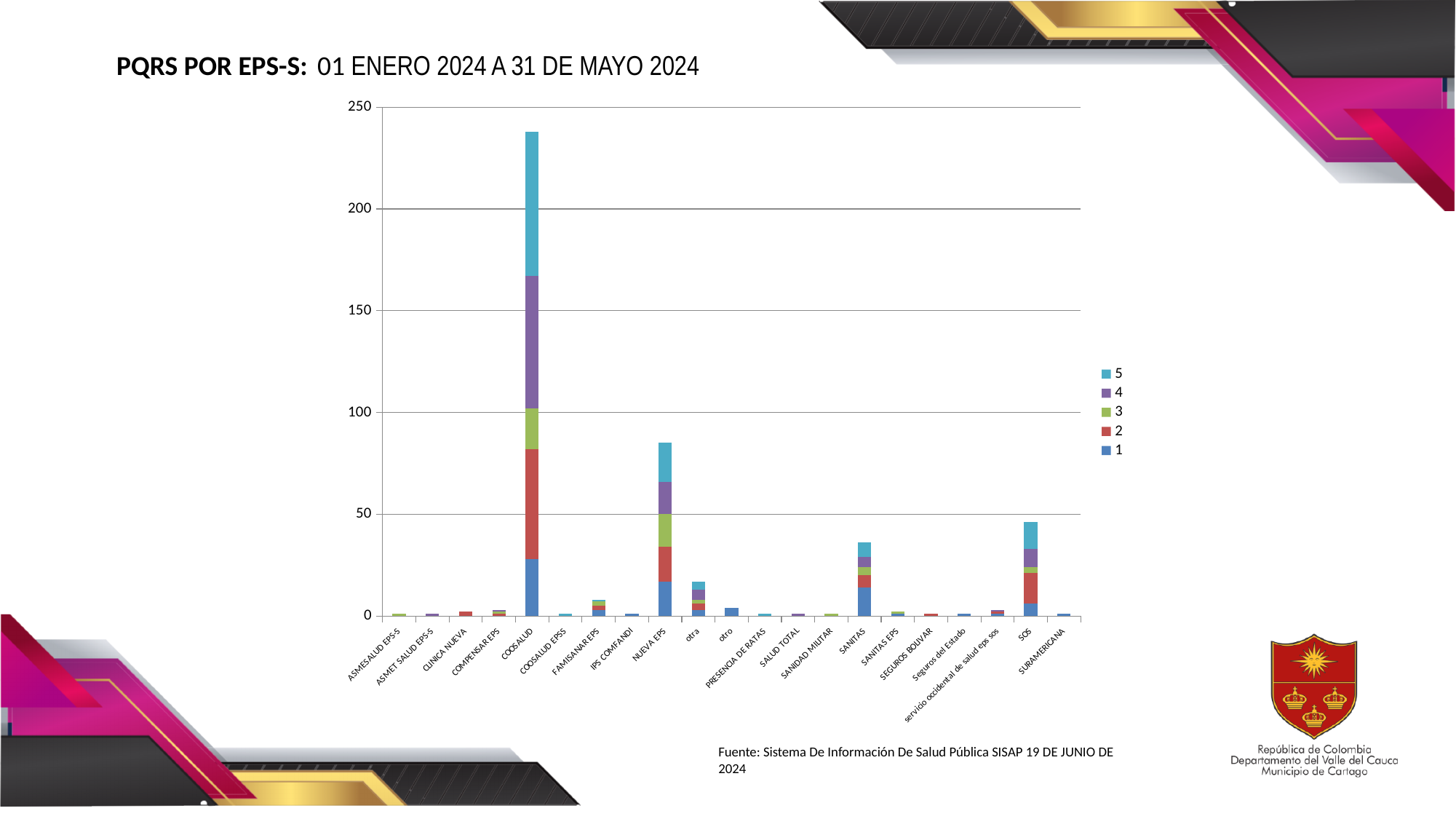
Which has a larger total bar, SANITAS or COOSALUD? COOSALUD Is the total value for SOS greater or less than 50? less Is the total value for COOSALUD greater or less than 200? greater What kind of chart is shown on the slide? Stacked bar chart Which EPS has the highest total bar? COOSALUD What is the title of the chart on the slide? PQRS POR EPS-S: 01 ENERO 2024 A 31 DE MAYO 2024 What are the entries listed in the legend? 5, 4, 3, 2, 1 How many EPS categories are shown on the x axis? 21 How many series does the legend list? 5 Is the total value for NUEVA EPS greater or less than 50? greater Which has a larger total bar, NUEVA EPS or SOS? NUEVA EPS